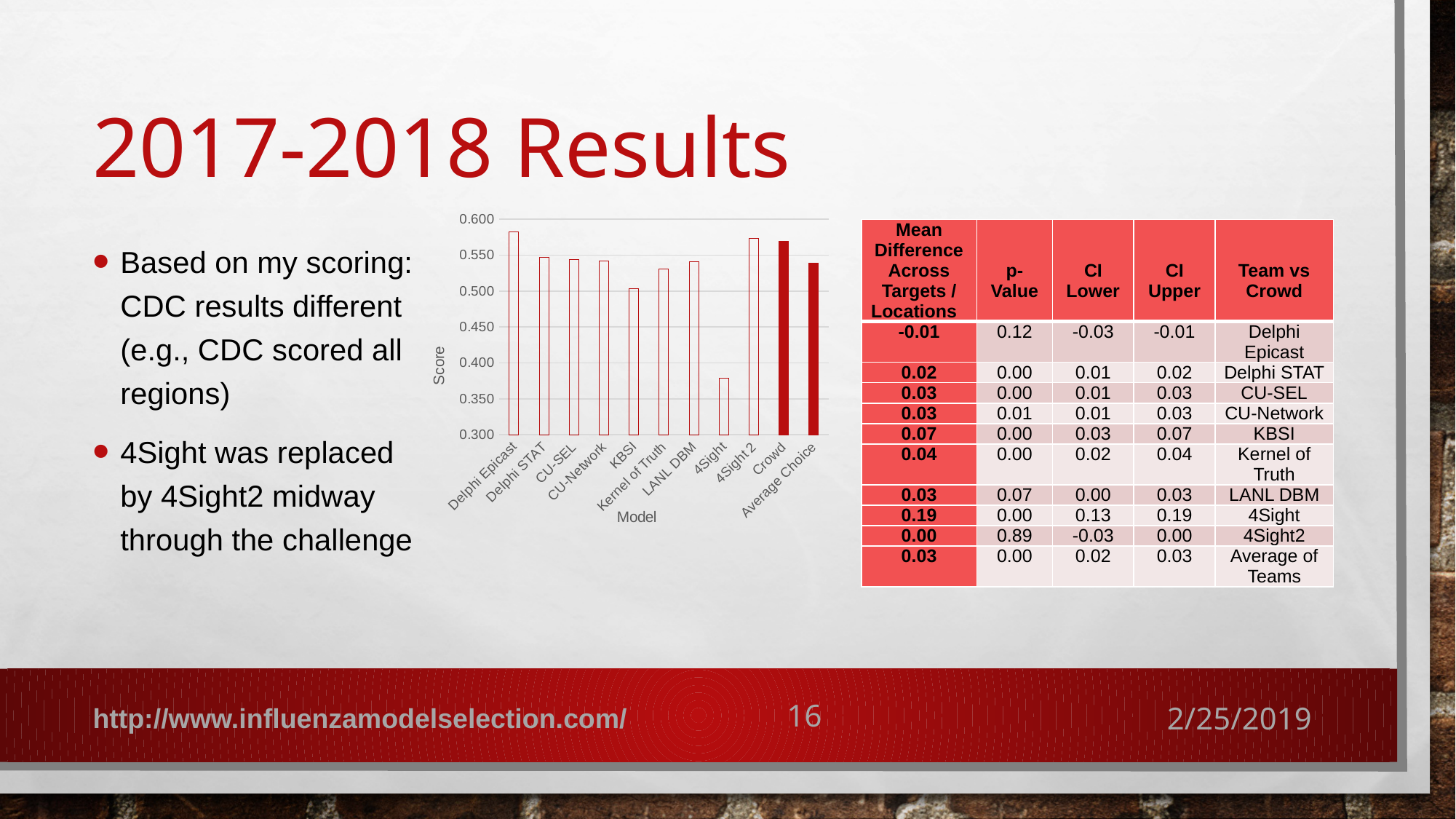
Is the score for Crowd greater or less than 0.550? greater What kind of chart is shown on the slide? bar chart Which has the higher score, 4Sight or 4Sight 2? 4Sight 2 Which model has the highest score in the chart? Delphi Epicast What is the label on the vertical axis of the chart? Score How many models are plotted on the x axis of the chart? 11 What is the label on the horizontal axis of the chart? Model Is the score for 4Sight greater or less than 0.400? less Is the score for KBSI greater or less than 0.550? less Which has the higher score, Crowd or Average Choice? Crowd Which model has the lowest score in the chart? 4Sight